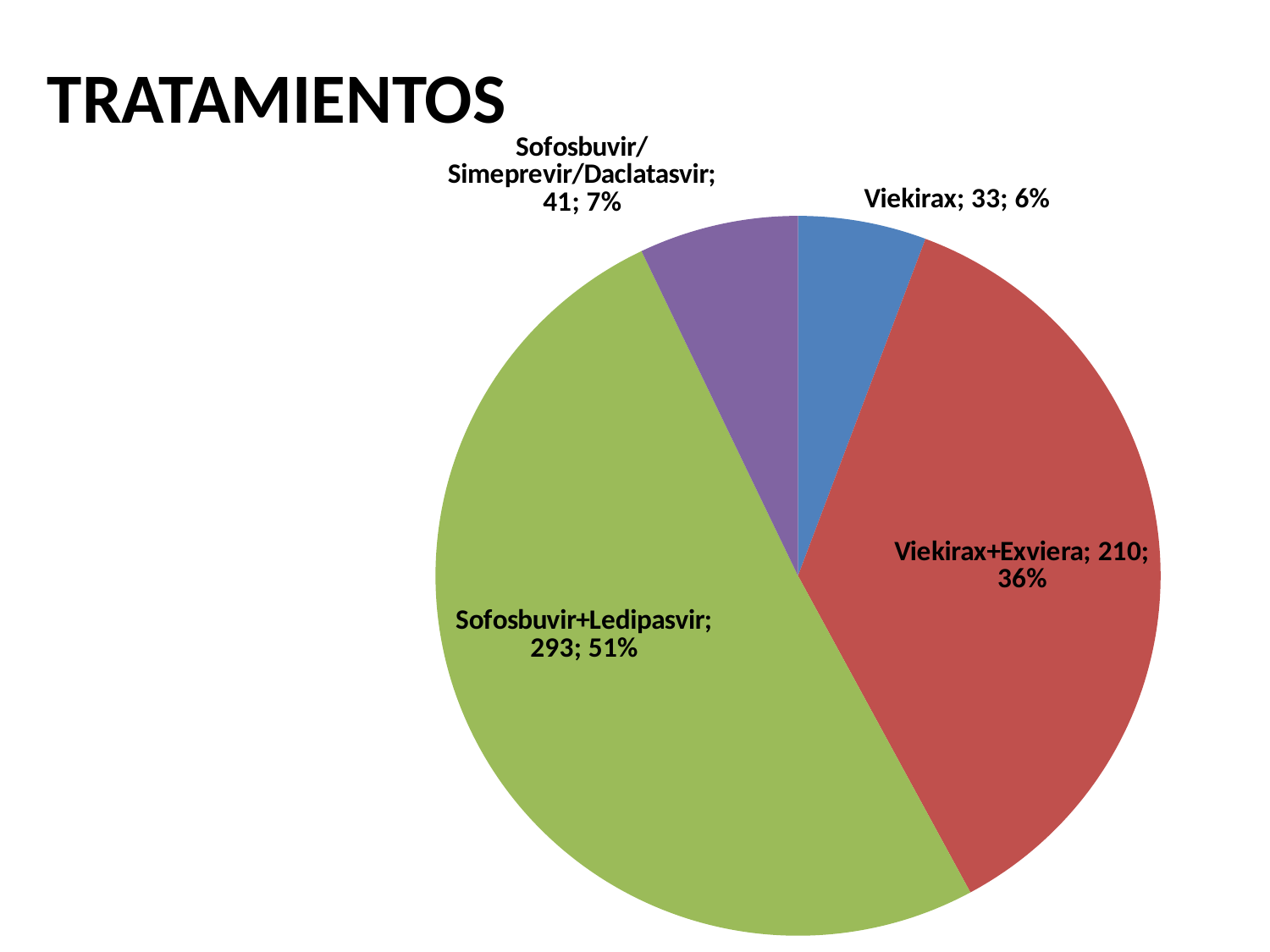
What is the value for Viekirax+Exviera? 210 Which treatment has the largest slice? Sofosbuvir+Ledipasvir What is the difference between the values for Sofosbuvir+Ledipasvir and Viekirax+Exviera? 83 What is the value for Viekirax? 33 What share of the pie does Viekirax represent? 6% What share of the pie does Sofosbuvir+Ledipasvir represent? 51% What kind of chart is shown on the slide? pie chart How many slices does the pie chart have? 4 What is the value for Sofosbuvir+Ledipasvir? 293 Which treatment has the smallest slice? Viekirax What is the value for Sofosbuvir/Simeprevir/Daclatasvir? 41 What is the title of the slide? TRATAMIENTOS